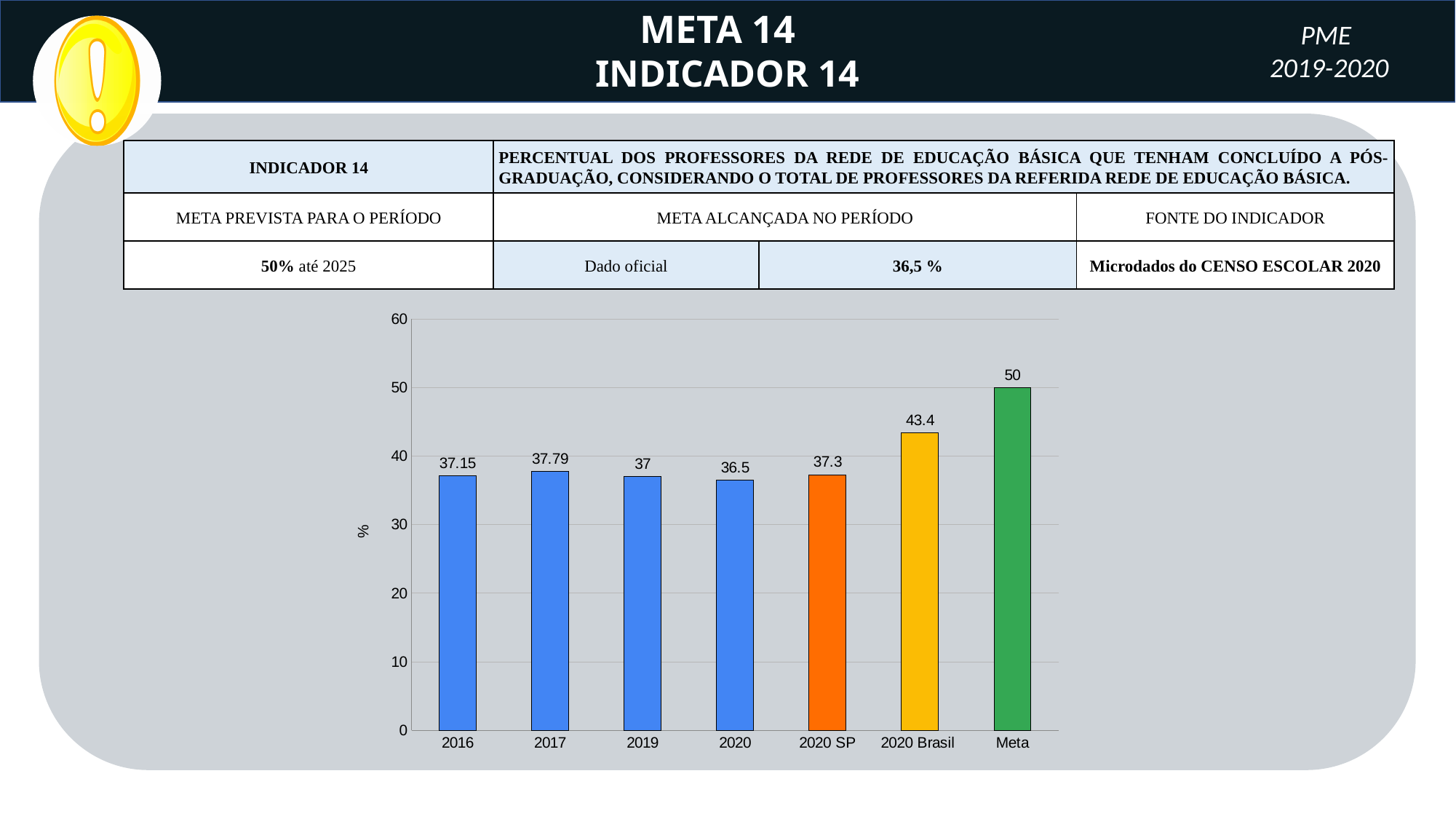
Which category has the highest value? Meta Is the value for 2020 Brasil greater or less than 40? greater What is the value for Meta? 50 Which category has the lowest value? 2020 What is the difference between 2020 Brasil and 2020 SP? 6.1 What is the difference between the Meta value and the 2020 value? 13.5 What is the value for 2016? 37.15 What type of chart is shown on the slide? bar chart What is the value for 2020 SP? 37.3 Which is larger, the value for 2017 or the value for 2019? 2017 How many bars are shown in the chart? 7 What is the value for 2020 Brasil? 43.4